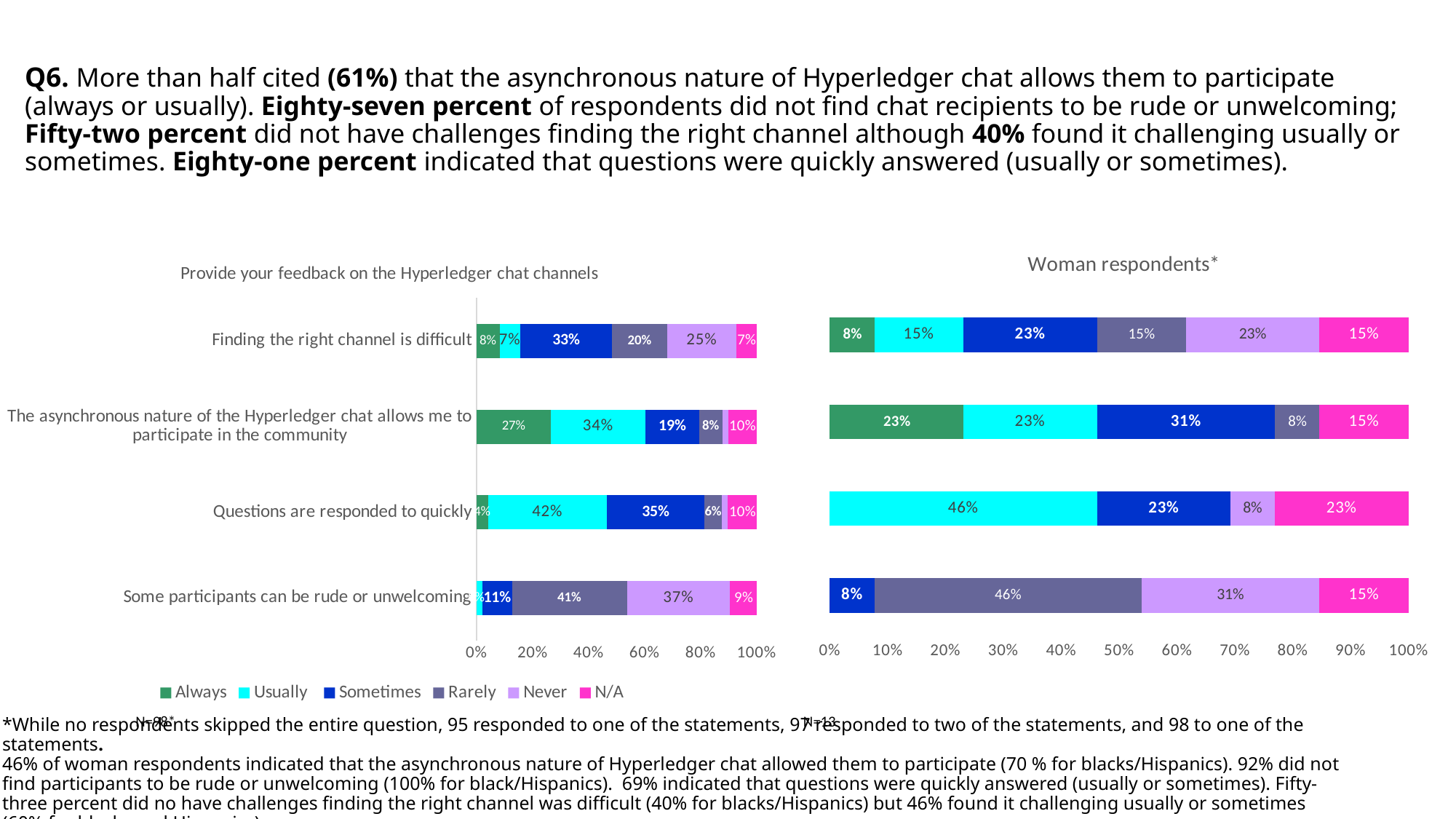
In the 'Woman respondents*' chart, what is the difference between the 'Rarely' and 'Never' values for 'Some participants can be rude or unwelcoming'? 15% In the 'Provide your feedback on the Hyperledger chat channels' chart, what is the 'Rarely' value for 'Some participants can be rude or unwelcoming'? 41% In the 'Provide your feedback on the Hyperledger chat channels' chart, what is the 'Usually' value for 'Questions are responded to quickly'? 42% How many series does the legend list? 6 In the 'Provide your feedback on the Hyperledger chat channels' chart, what is the 'Sometimes' value for 'Finding the right channel is difficult'? 33% In the 'Provide your feedback on the Hyperledger chat channels' chart, what is the difference between the 'Usually' and 'Always' values for 'The asynchronous nature of the Hyperledger chat allows me to participate in the community'? 7% In the 'Woman respondents*' chart, which is larger for 'Some participants can be rude or unwelcoming': the 'Rarely' value or the 'Never' value? Rarely In the 'Provide your feedback on the Hyperledger chat channels' chart, which statement has the highest 'Never' value? Some participants can be rude or unwelcoming In the 'Woman respondents*' chart, what is the 'Sometimes' value for 'The asynchronous nature of the Hyperledger chat allows me to participate in the community'? 31% How many statements (categories) are shown in the 'Woman respondents*' chart? 4 In the 'Woman respondents*' chart, what is the 'Usually' value for 'Questions are responded to quickly'? 46% What kind of chart is the 'Woman respondents*' chart? Stacked bar chart